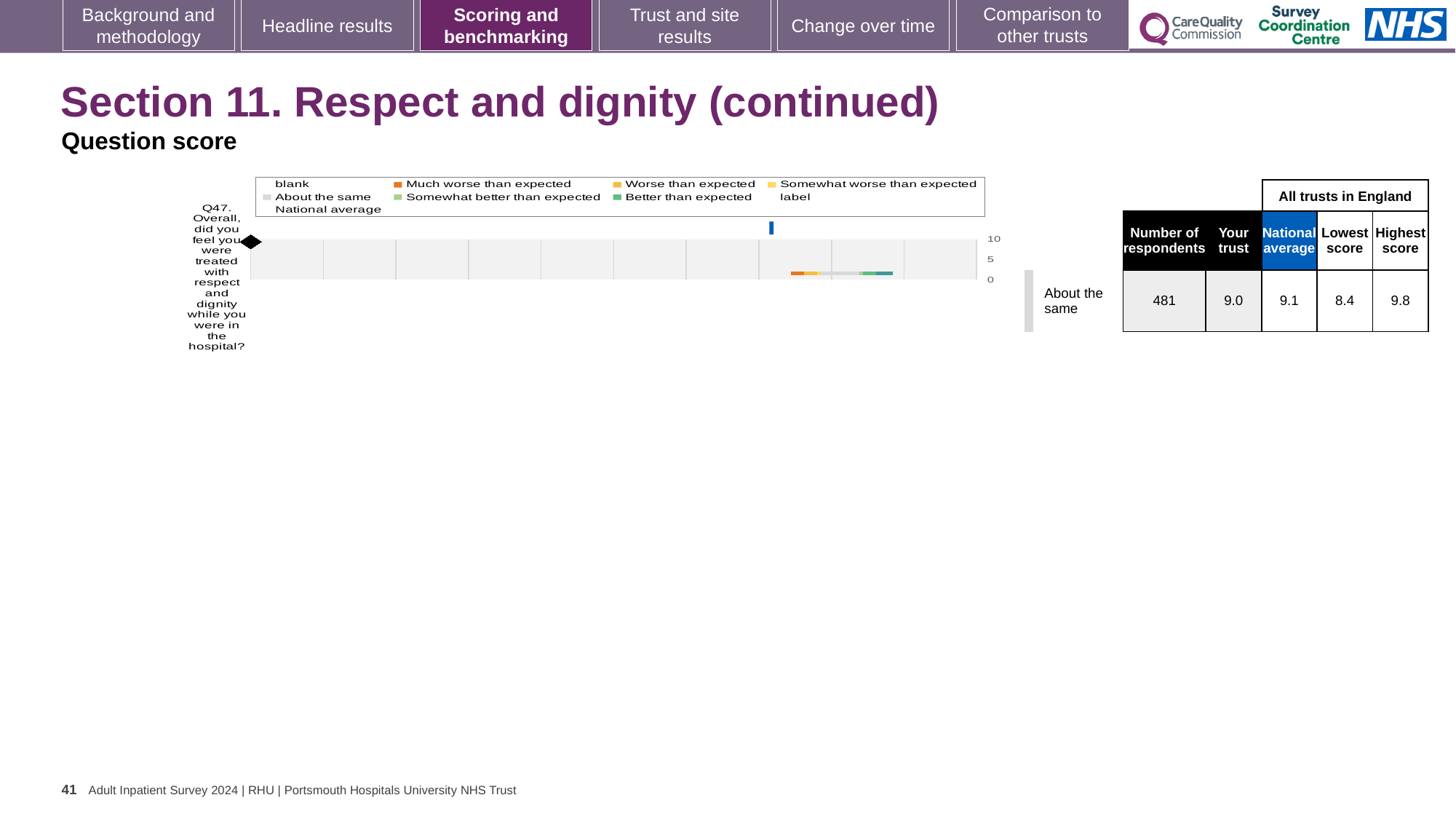
How many respondents answered Q47? 481 What colour does the legend use for 'Much worse than expected'? Orange Is the trust's score for Q47 greater or less than 5 on the chart's axis? greater Which is larger for Q47: the trust's score or the national average? National average What kind of chart is shown on the slide for Q47? bar chart What is the difference between the highest and lowest scores for Q47 across all trusts in England? 1.4 What is the highest score among all trusts in England for Q47? 9.8 How many questions are plotted on the chart? 1 What is the national average score for Q47? 9.1 What is the lowest score among all trusts in England for Q47? 8.4 What is the 'Your trust' score for Q47 (treated with respect and dignity)? 9.0 Which benchmarking category is the trust's Q47 score placed in? About the same